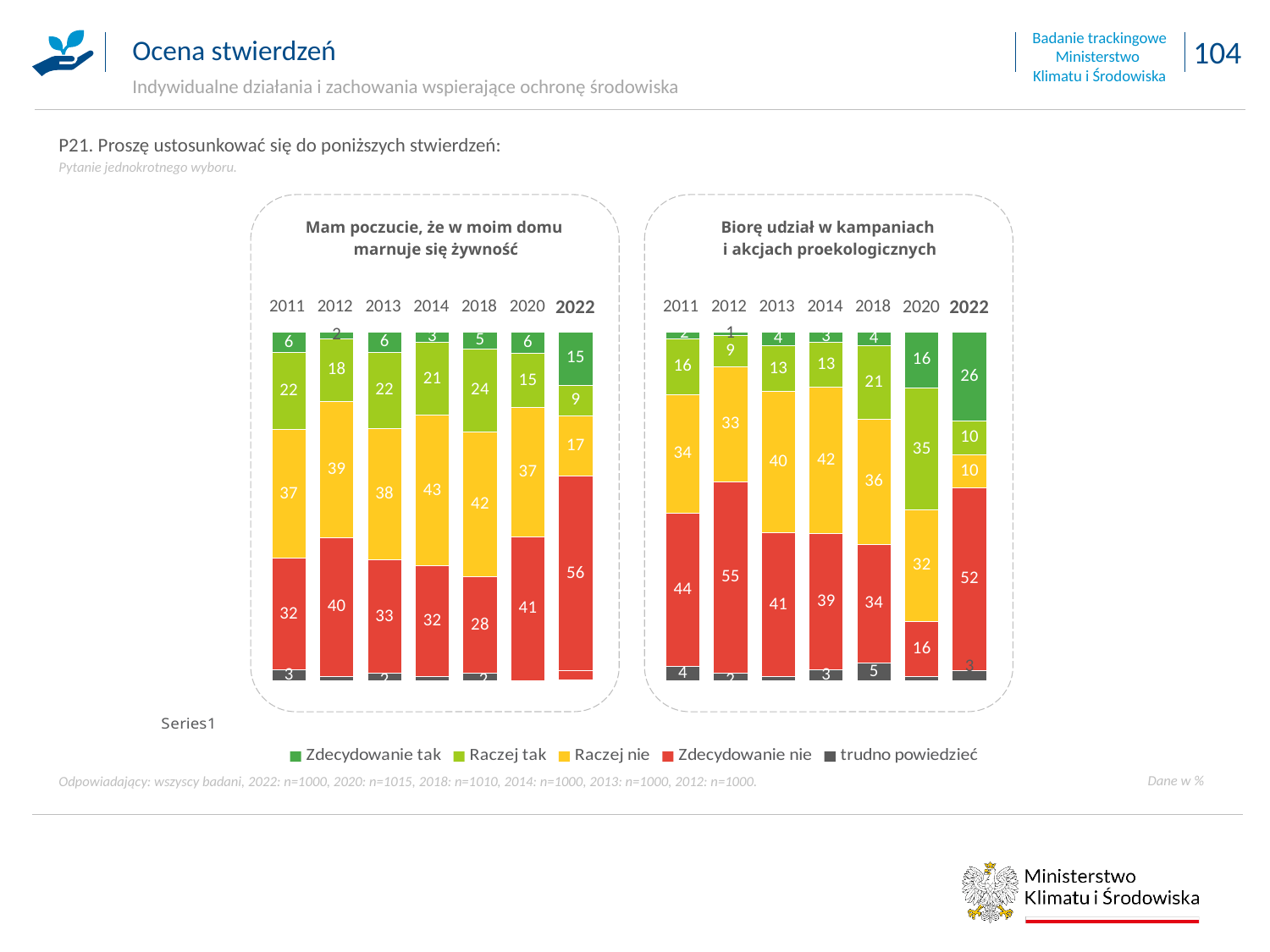
In the left chart ("Mam poczucie, że w moim domu marnuje się żywność"), what is the difference between the "Raczej nie" values for 2014 and 2022? 26 How many years are shown on the x axis of the left chart ("Mam poczucie, że w moim domu marnuje się żywność")? 7 In the left chart ("Mam poczucie, że w moim domu marnuje się żywność"), what is the value for "Zdecydowanie nie" in 2022? 56 In the right chart ("Biorę udział w kampaniach i akcjach proekologicznych"), what is the difference between the "Zdecydowanie nie" values for 2012 and 2011? 11 What kind of chart is used on this slide? Stacked bar chart How many series does the legend list? 5 In the right chart ("Biorę udział w kampaniach i akcjach proekologicznych"), which year has the lowest value for "Zdecydowanie nie"? 2020 In the right chart ("Biorę udział w kampaniach i akcjach proekologicznych"), what is the value for "Zdecydowanie tak" in 2022? 26 In the right chart ("Biorę udział w kampaniach i akcjach proekologicznych"), which year has the larger "Raczej tak" value, 2018 or 2020? 2020 In the right chart ("Biorę udział w kampaniach i akcjach proekologicznych"), what is the value for "Raczej nie" in 2014? 42 In the left chart ("Mam poczucie, że w moim domu marnuje się żywność"), which year has the highest value for "Zdecydowanie nie"? 2022 In the right chart ("Biorę udział w kampaniach i akcjach proekologicznych"), does the "Zdecydowanie tak" value rise or fall from 2018 to 2022? Rises